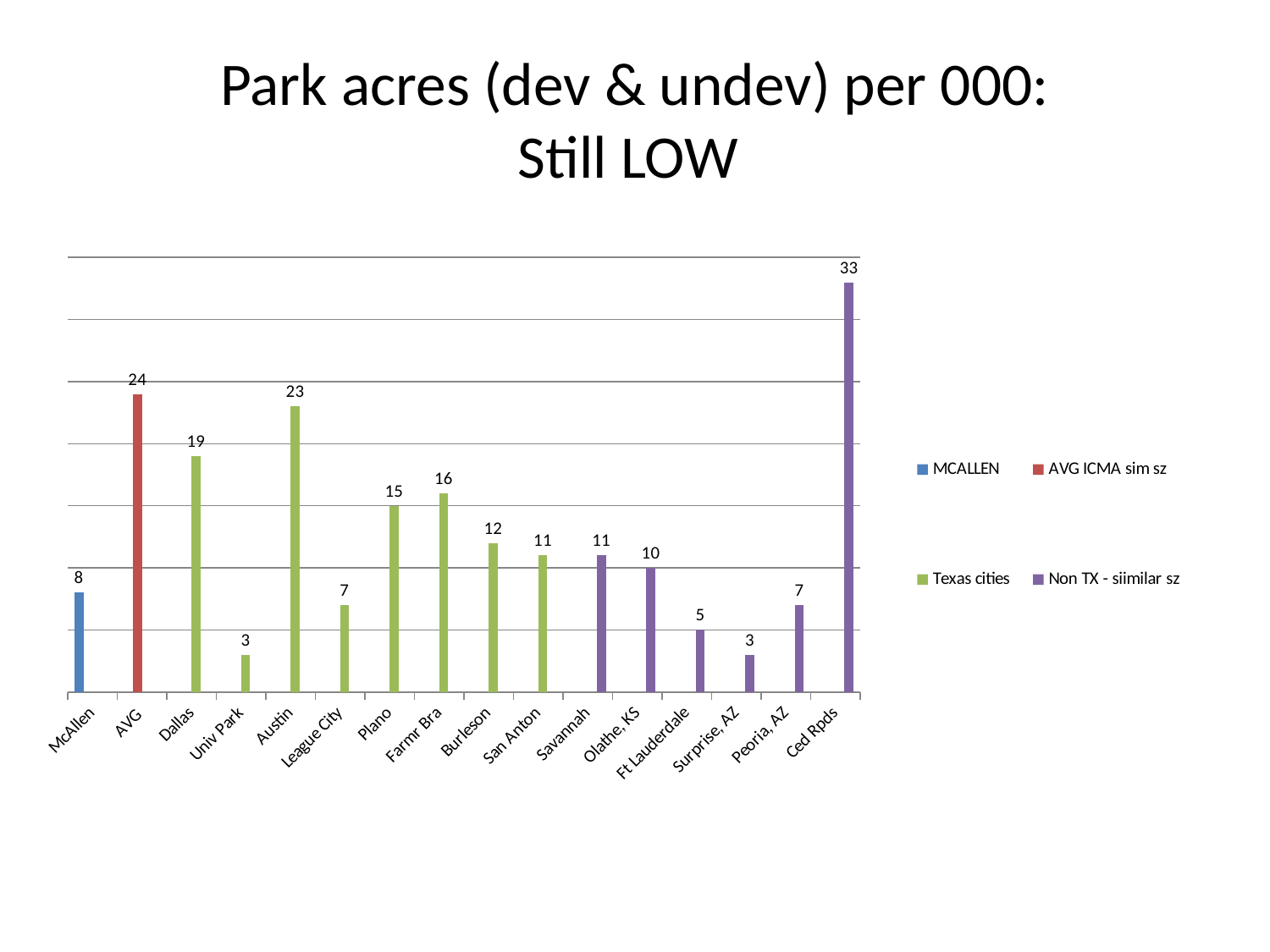
What is the value for Ft Lauderdale? 5 What is the value for AVG? 24 Which category has the highest value? Ced Rpds What is the value for McAllen? 8 What is the difference between the values for Austin and McAllen? 15 What kind of chart is shown on the slide? Bar chart Which is larger, the value for Plano or the value for Farmr Bra? Farmr Bra What is the value for Dallas? 19 How many series does the legend list? 4 What is the difference between the values for Ced Rpds and AVG? 9 How many categories are shown on the x axis? 16 Which is larger, the value for Olathe, KS or the value for Peoria, AZ? Olathe, KS